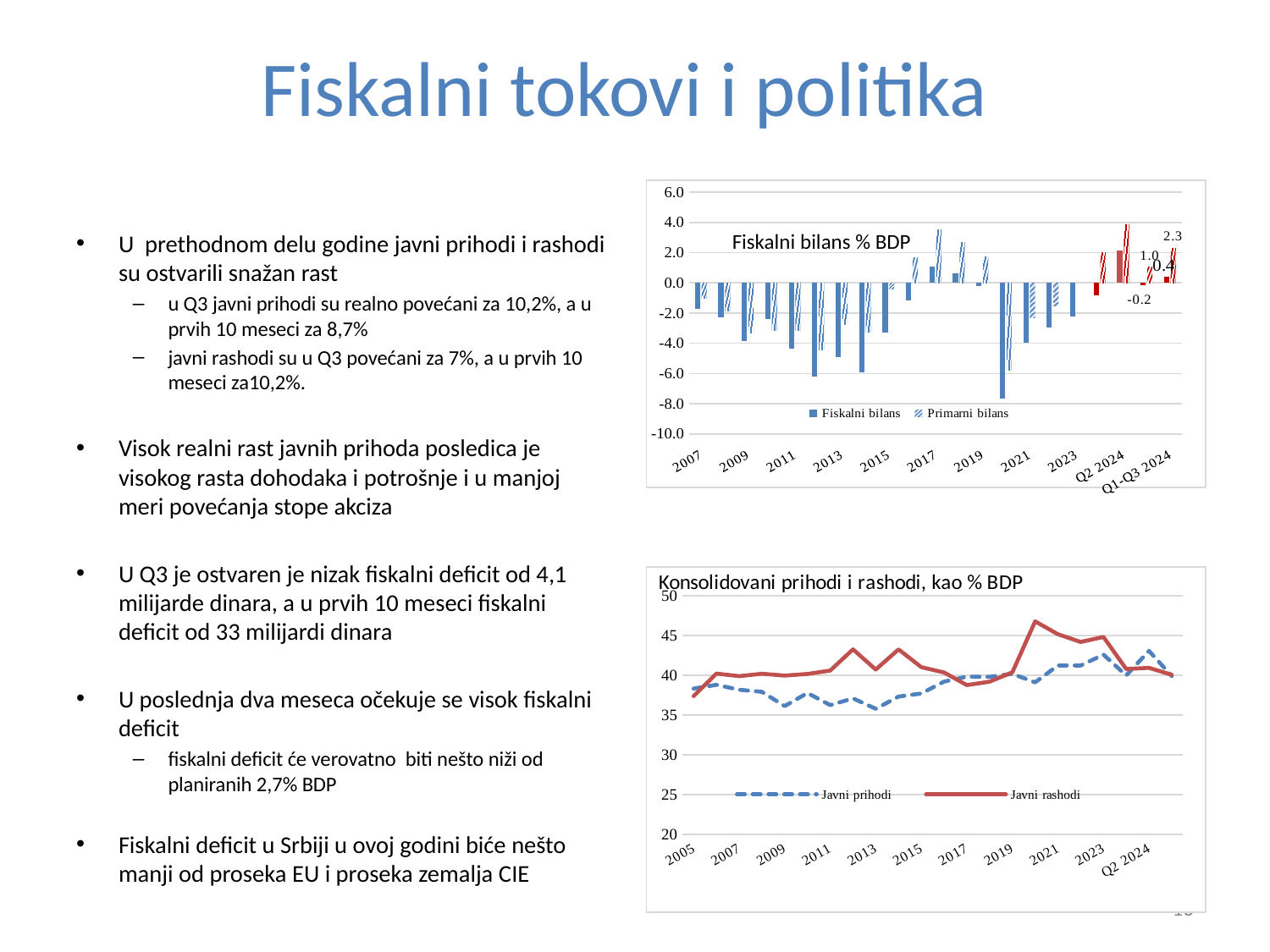
In the bottom chart "Konsolidovani prihodi i rashodi, kao % BDP", in which year does Javni rashodi reach its highest value? 2020 In the top chart "Fiskalni bilans % BDP", is the Fiskalni bilans value for 2020 greater or less than -6.0? less In the bottom chart "Konsolidovani prihodi i rashodi, kao % BDP", does Javni prihodi rise or fall from 2013 to 2017? rise What kind of chart is the bottom chart titled "Konsolidovani prihodi i rashodi, kao % BDP"? line chart In the bottom chart "Konsolidovani prihodi i rashodi, kao % BDP", which is larger in 2020, Javni prihodi or Javni rashodi? Javni rashodi In the top chart "Fiskalni bilans % BDP", which year has the lowest Fiskalni bilans value? 2020 In the top chart "Fiskalni bilans % BDP", is the Primarni bilans value for 2017 greater or less than 2.0? greater In the bottom chart "Konsolidovani prihodi i rashodi, kao % BDP", is the Javni rashodi value for 2020 greater or less than 45? greater How many series does the legend of the top chart "Fiskalni bilans % BDP" list? 2 What kind of chart is the top chart titled "Fiskalni bilans % BDP"? bar chart Which two series are listed in the legend of the bottom chart "Konsolidovani prihodi i rashodi, kao % BDP"? Javni prihodi and Javni rashodi